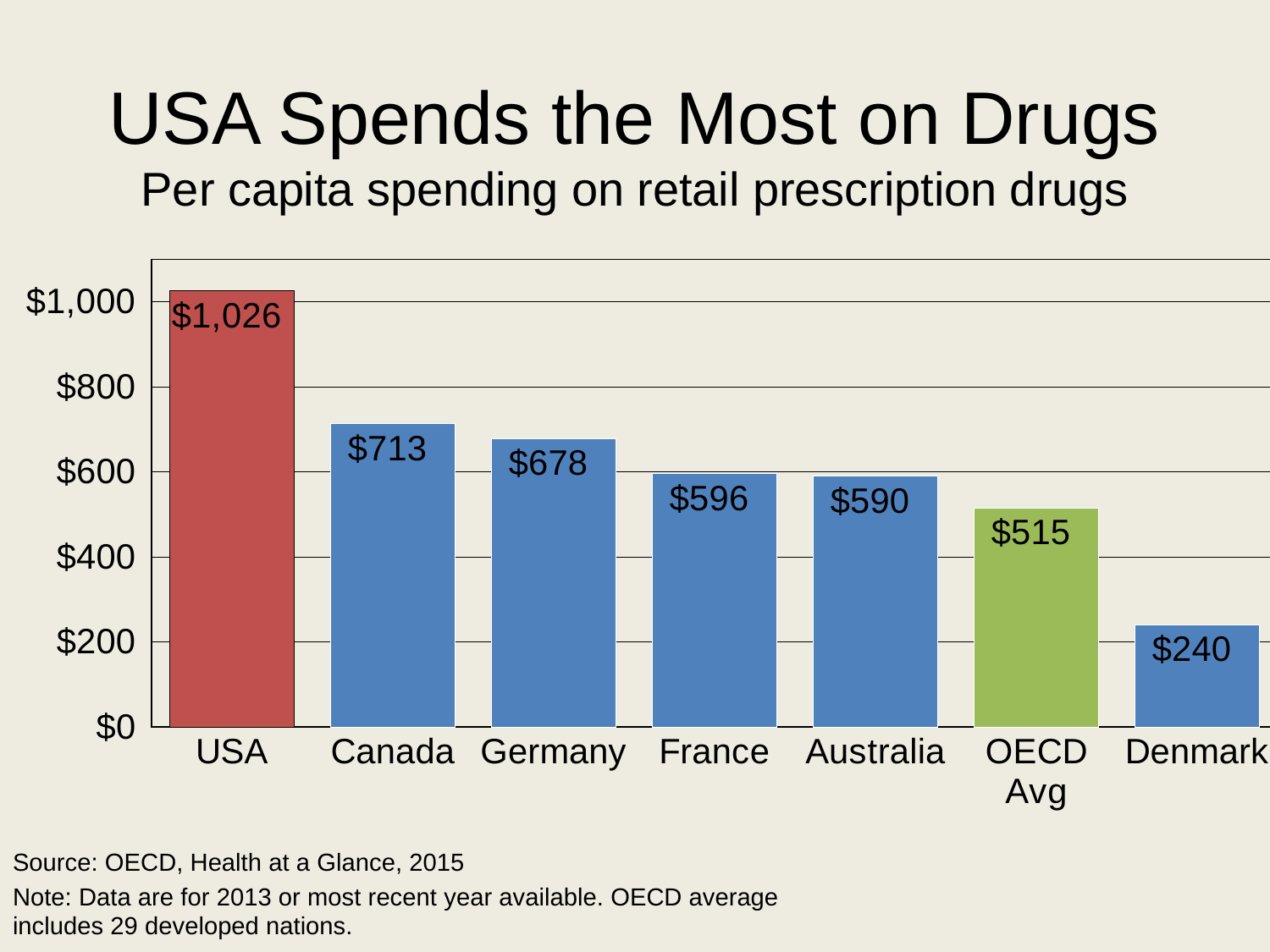
What kind of chart is shown on the slide? Bar chart What is the value shown for the OECD Avg bar? $515 Is the value for Germany greater or less than $600? greater What is the difference between the USA value and the Canada value? $313 How much higher is Germany's spending than the OECD Avg? $163 What is the per capita spending shown for Denmark? $240 What is the per capita spending on retail prescription drugs for Canada? $713 Which category has the lowest per capita spending? Denmark Which category has the highest per capita spending? USA How many bars are shown in the chart? 7 Which bar is coloured green? OECD Avg Which is larger, the value for France or the value for Australia? France